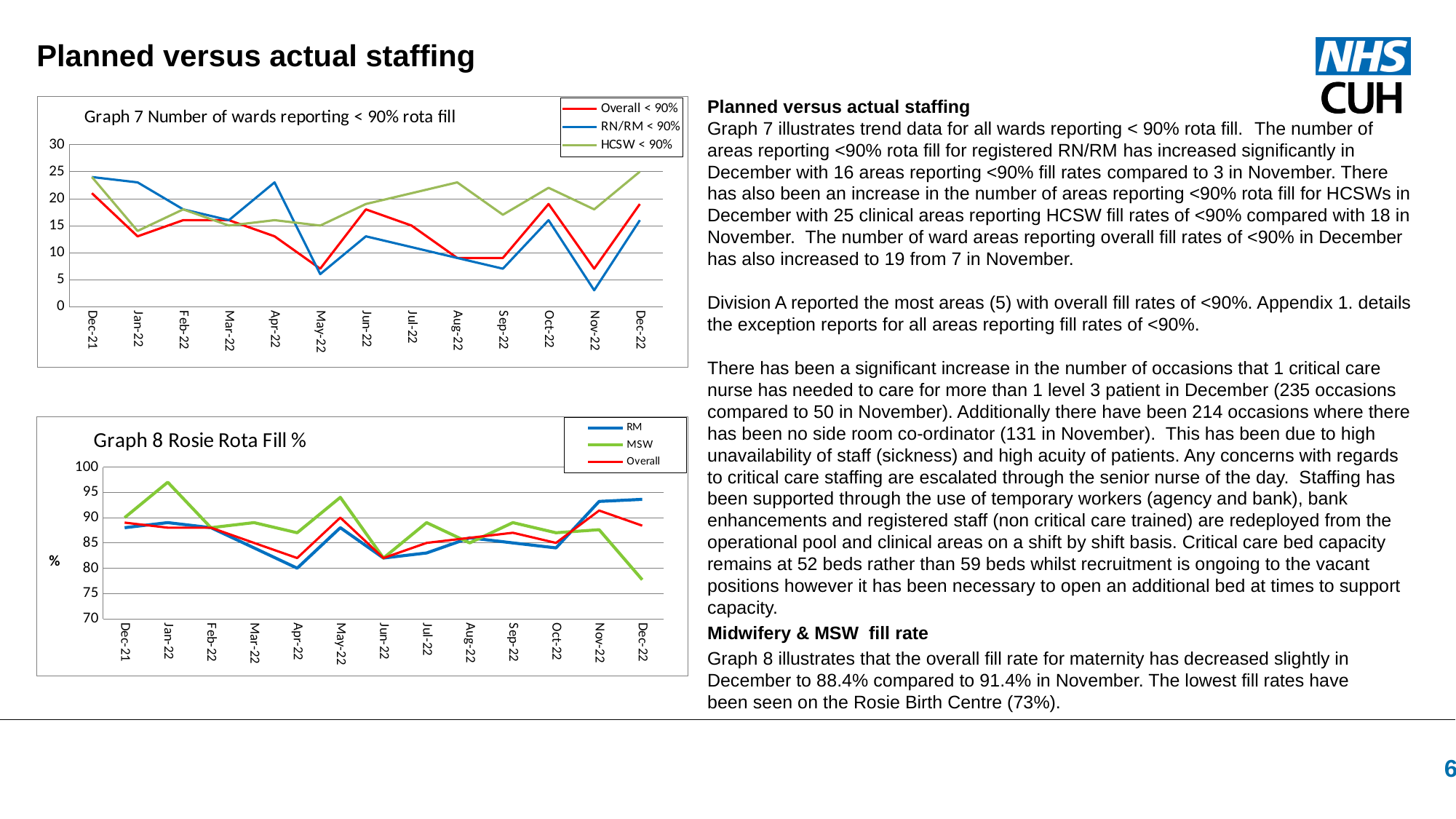
In Graph 7 Number of wards reporting < 90% rota fill, which is larger in Dec-22: HCSW < 90% or RN/RM < 90%? HCSW < 90% How many series does the legend of Graph 7 Number of wards reporting < 90% rota fill list? 3 In Graph 7 Number of wards reporting < 90% rota fill, what is the HCSW < 90% value for Dec-22? 25 In Graph 8 Rosie Rota Fill %, in which month is the MSW series at its lowest? Dec-22 In Graph 8 Rosie Rota Fill %, does the MSW series rise or fall from Nov-22 to Dec-22? fall In Graph 8 Rosie Rota Fill %, in which month is the MSW series at its highest? Jan-22 In Graph 7 Number of wards reporting < 90% rota fill, is the Overall < 90% value for May-22 greater or less than 10? less In Graph 8 Rosie Rota Fill %, is the MSW value for Dec-22 greater or less than 80? less In Graph 7 Number of wards reporting < 90% rota fill, in which month is the RN/RM < 90% series at its lowest? Nov-22 How many months are plotted along the x axis of Graph 8 Rosie Rota Fill %? 13 What type of chart is Graph 7 Number of wards reporting < 90% rota fill? line chart In Graph 7 Number of wards reporting < 90% rota fill, is the RN/RM < 90% value for Nov-22 greater or less than 5? less